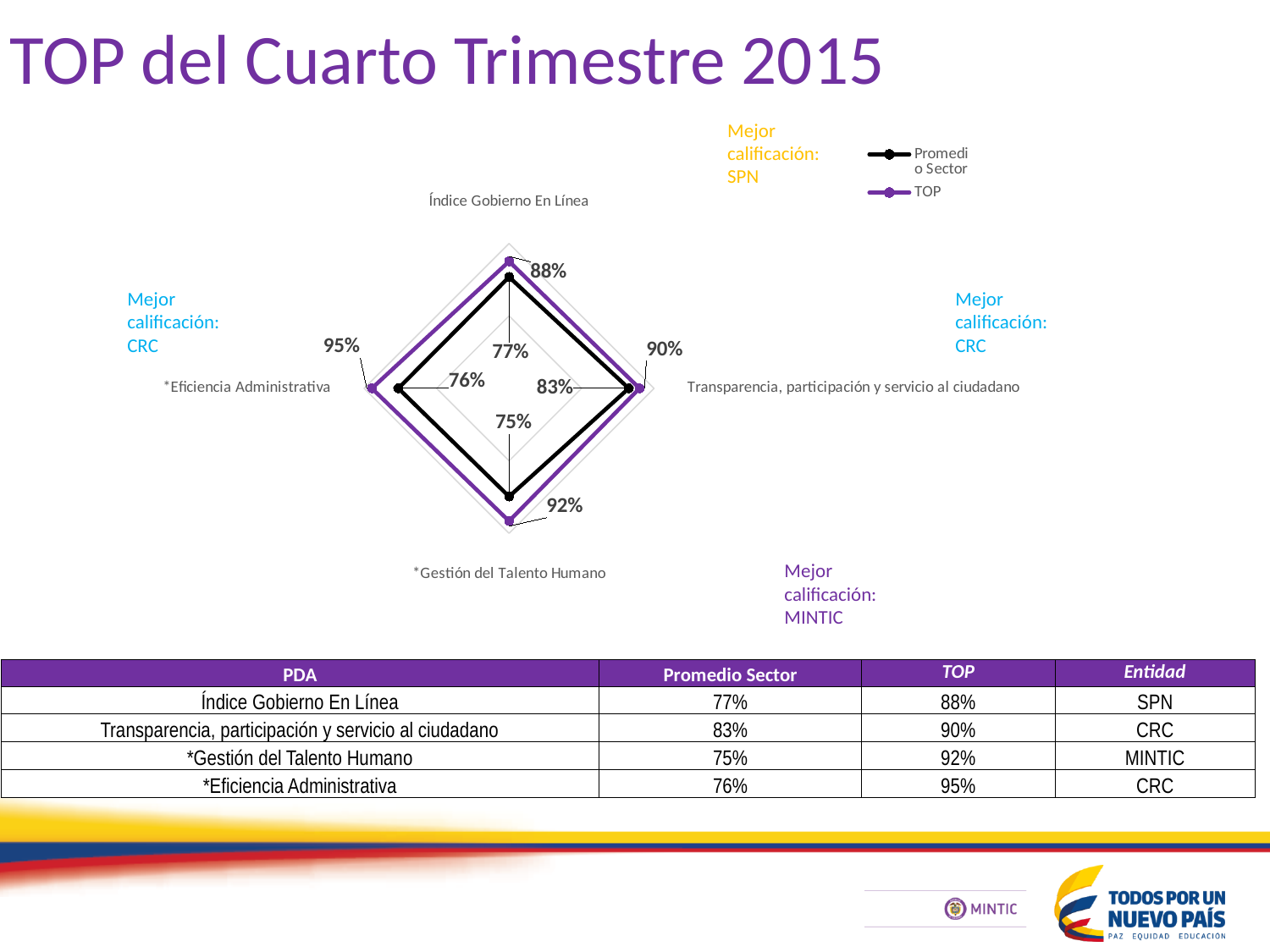
Which category has the lowest Promedio Sector value? *Gestión del Talento Humano What is the Promedio Sector value for *Gestión del Talento Humano? 75% What is the Promedio Sector value for Transparencia, participación y servicio al ciudadano? 83% Which is larger for *Gestión del Talento Humano: the TOP value or the Promedio Sector value? TOP What is the TOP value for Índice Gobierno En Línea? 88% Which series is drawn in purple on the chart? TOP What kind of chart is shown on the slide? Radar chart Which category has the highest TOP value? *Eficiencia Administrativa What is the TOP value for *Eficiencia Administrativa? 95% How many series does the chart legend list? 2 What is the difference between the TOP and Promedio Sector values for *Eficiencia Administrativa? 19% How many categories (axes) does the radar chart have? 4